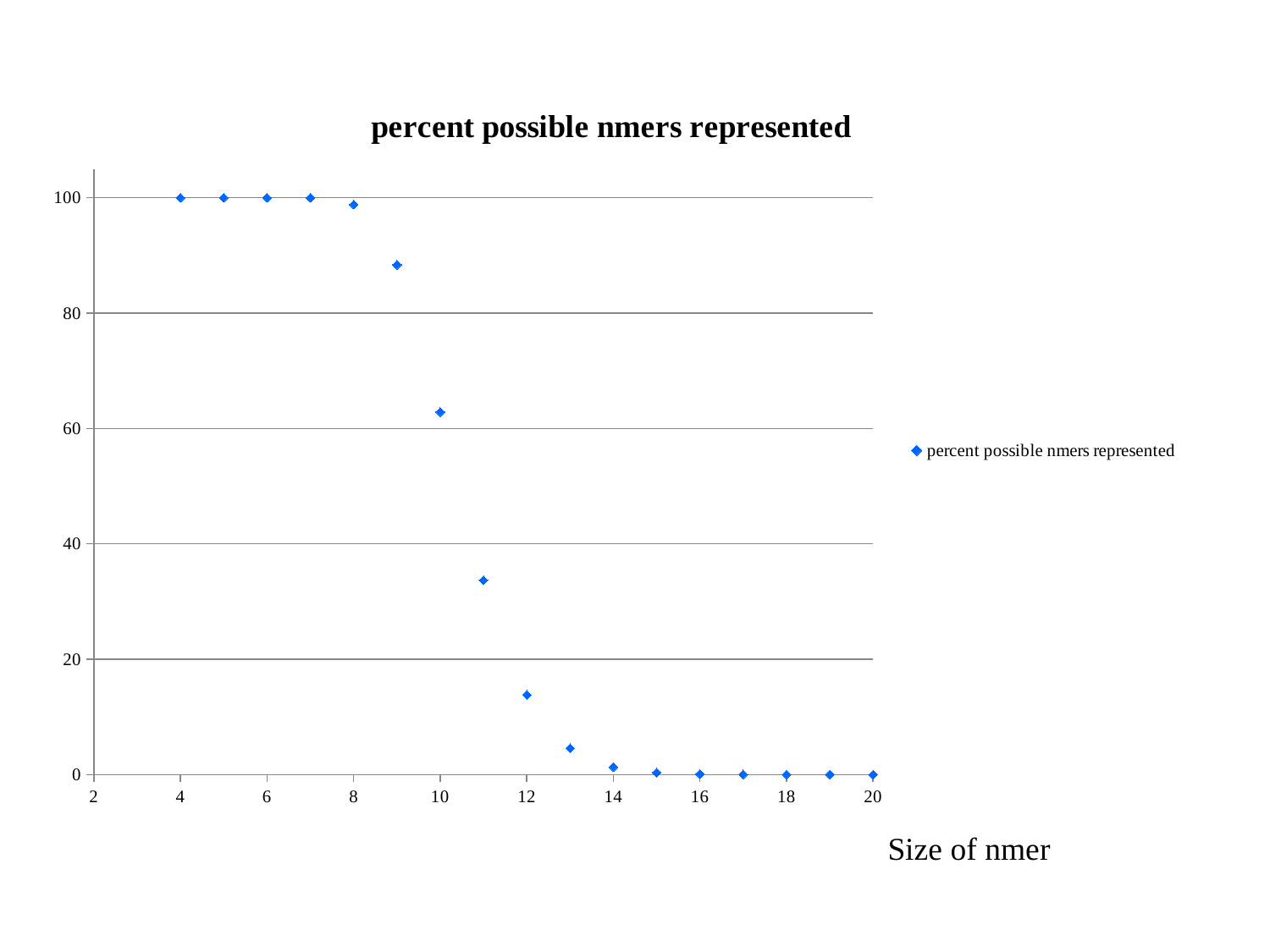
Is the value for nmer size 9 greater or less than 80? greater Is the value for nmer size 10 greater or less than 60? greater Do the values rise or fall as the size of nmer increases along the x axis? fall How many series does the legend list? 1 What kind of chart is shown on the slide? scatter chart Which has the larger value, nmer size 10 or nmer size 12? nmer size 10 How many data points are plotted in the chart? 17 What is the title of the chart? percent possible nmers represented What is the label shown below the x axis? Size of nmer What is the value for nmer size 6? 100 What is the value for nmer size 4? 100 Is the value for nmer size 11 greater or less than 40? less